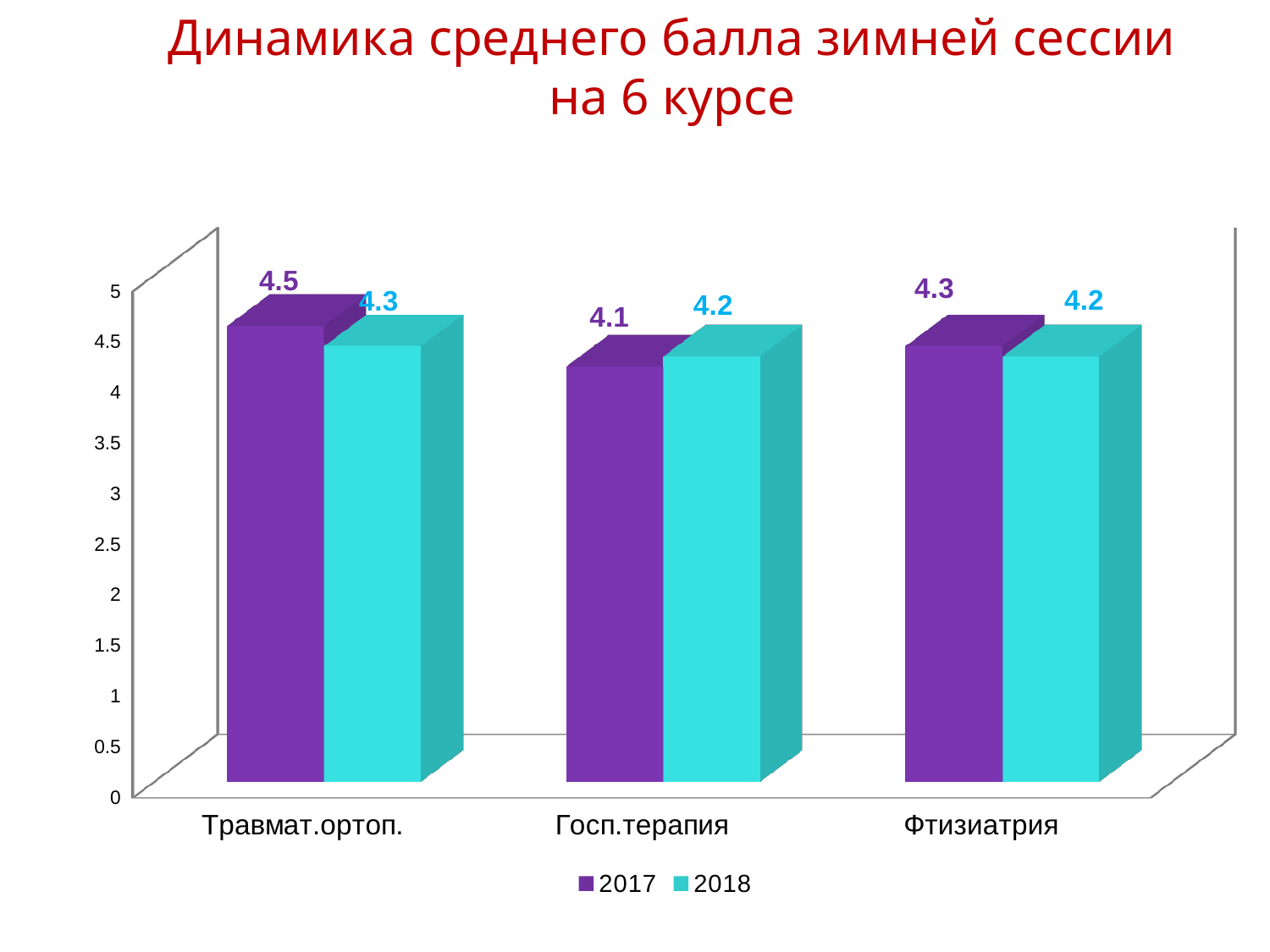
What kind of chart is shown on the slide? Bar chart Which category has the lowest value in the 2017 series? Госп.терапия What is the difference between the 2017 and 2018 values for Травмат.ортоп.? 0.2 How many categories are shown on the x axis? 3 How many series does the legend list? 2 Which colour represents the 2018 series? Cyan What is the value for Травмат.ортоп. in the 2017 series? 4.5 What is the title of the chart? Динамика среднего балла зимней сессии на 6 курсе What is the value for Госп.терапия in the 2018 series? 4.2 Which category has the highest value in the 2017 series? Травмат.ортоп. Which is larger for Госп.терапия, the 2017 value or the 2018 value? 2018 What is the value for Фтизиатрия in the 2017 series? 4.3